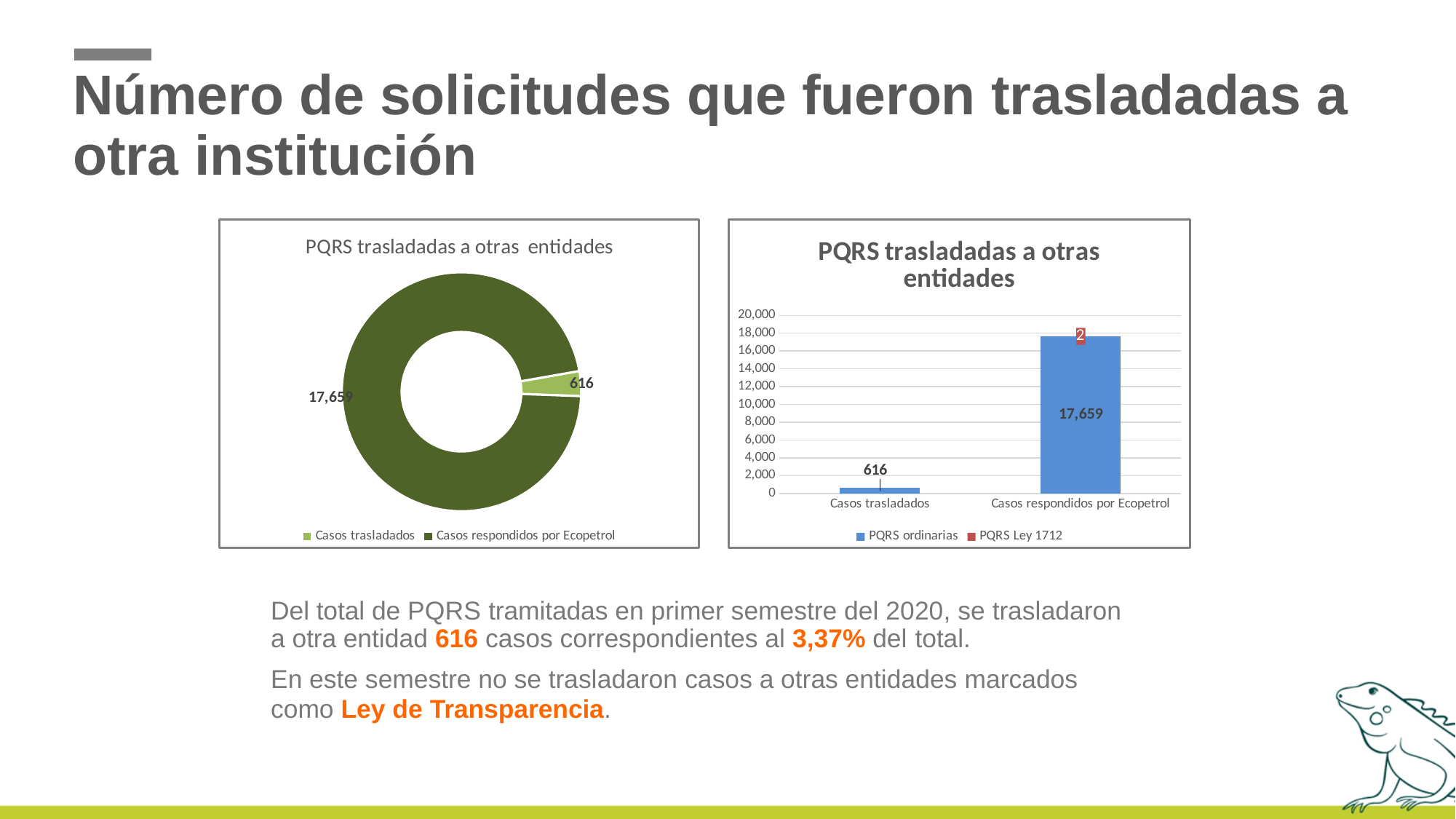
In the chart on the left, what is the value for Casos trasladados? 616 What kind of chart is the chart on the left of the slide? doughnut chart In the chart on the right, what is the total of the stacked bar for Casos respondidos por Ecopetrol? 17,661 How many slices does the chart on the left have? 2 In the chart on the right, what is the PQRS ordinarias value for Casos trasladados? 616 In the chart on the right, what is the difference between the PQRS ordinarias values for Casos respondidos por Ecopetrol and Casos trasladados? 17,043 In the chart on the left, which slice is larger, Casos trasladados or Casos respondidos por Ecopetrol? Casos respondidos por Ecopetrol In the chart on the right, what is the PQRS Ley 1712 value for Casos respondidos por Ecopetrol? 2 How many series does the legend of the chart on the right list? 2 In the chart on the left, what is the value for Casos respondidos por Ecopetrol? 17,659 What kind of chart is the chart on the right of the slide? bar chart In the chart on the right, is the bar for Casos respondidos por Ecopetrol greater or less than 16,000? greater